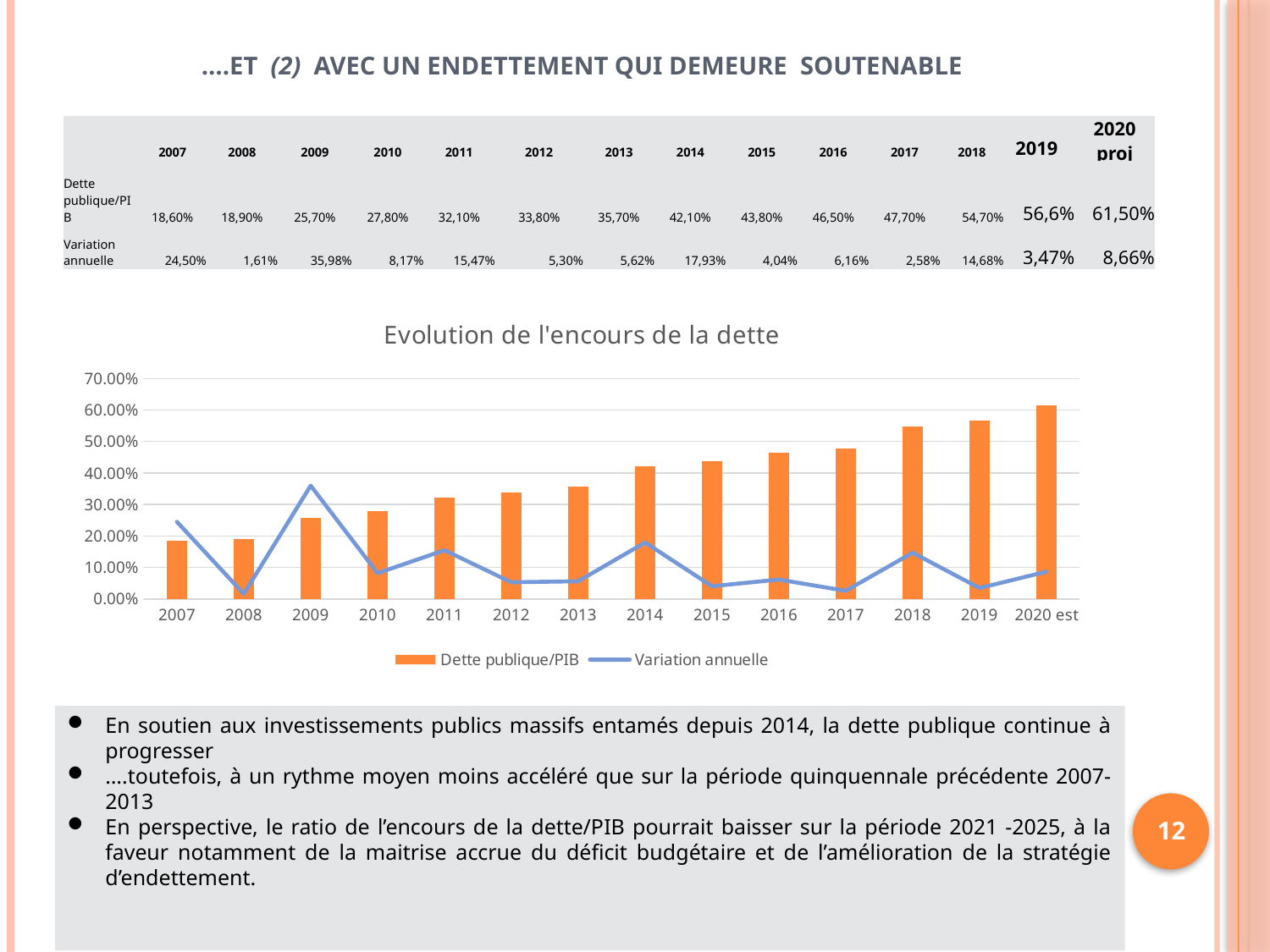
Does 'Dette publique/PIB' generally rise or fall from 2007 to 2020 est? rise According to the table, what is the value of 'Dette publique/PIB' for 2014? 42,10% What kind of chart is 'Evolution de l'encours de la dette'? A bar chart combined with a line In which year does the 'Variation annuelle' line reach its highest point? 2009 Which year has the larger 'Variation annuelle', 2009 or 2014? 2009 Is the 'Variation annuelle' value for 2016 greater or less than 10.00%? less According to the table, what is the 'Variation annuelle' for 2009? 35,98% In which year is the 'Dette publique/PIB' bar the highest? 2020 est How many years are shown on the x axis of the chart 'Evolution de l'encours de la dette'? 14 Is the 'Dette publique/PIB' bar for 2018 greater or less than 50.00%? greater In which year is the 'Dette publique/PIB' bar the lowest? 2007 How many series does the legend of the chart 'Evolution de l'encours de la dette' list? 2